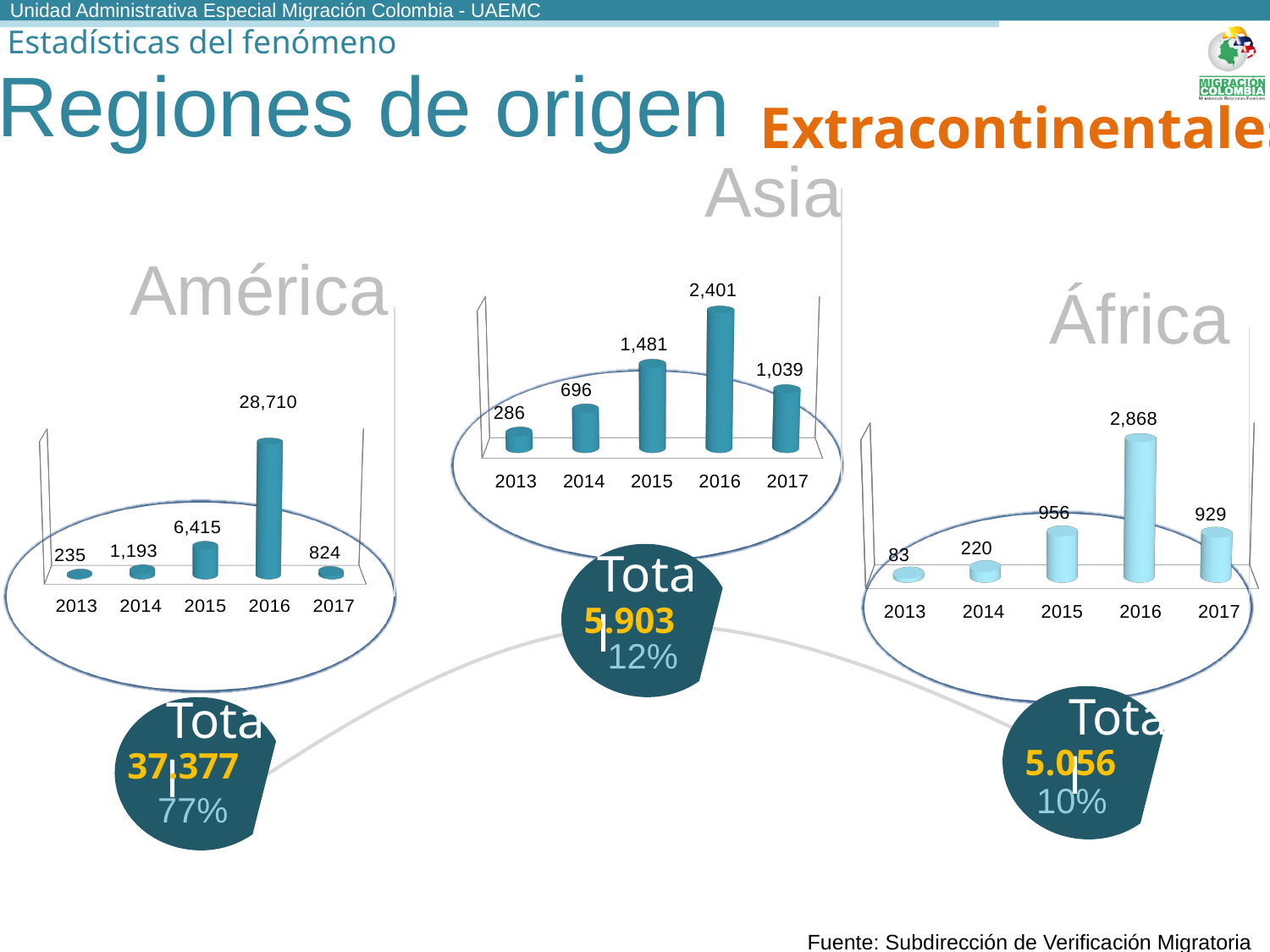
In the Asia chart, what is the value for 2015? 1,481 In the África chart, what is the difference between the values for 2016 and 2017? 1,939 In the Asia chart, which year has the lowest value? 2013 In the Asia chart, which is larger, the value for 2017 or the value for 2014? 2017 In the Asia chart, do the values rise or fall from 2013 to 2016? rise In the África chart, what is the value for 2014? 220 In the América chart, which is larger, the value for 2013 or the value for 2017? 2017 What kind of chart is the Asia chart? bar chart In the América chart, what is the value for 2016? 28,710 How many years are shown in the América chart? 5 In the América chart, what is the difference between the values for 2015 and 2014? 5,222 In the África chart, which year has the highest value? 2016